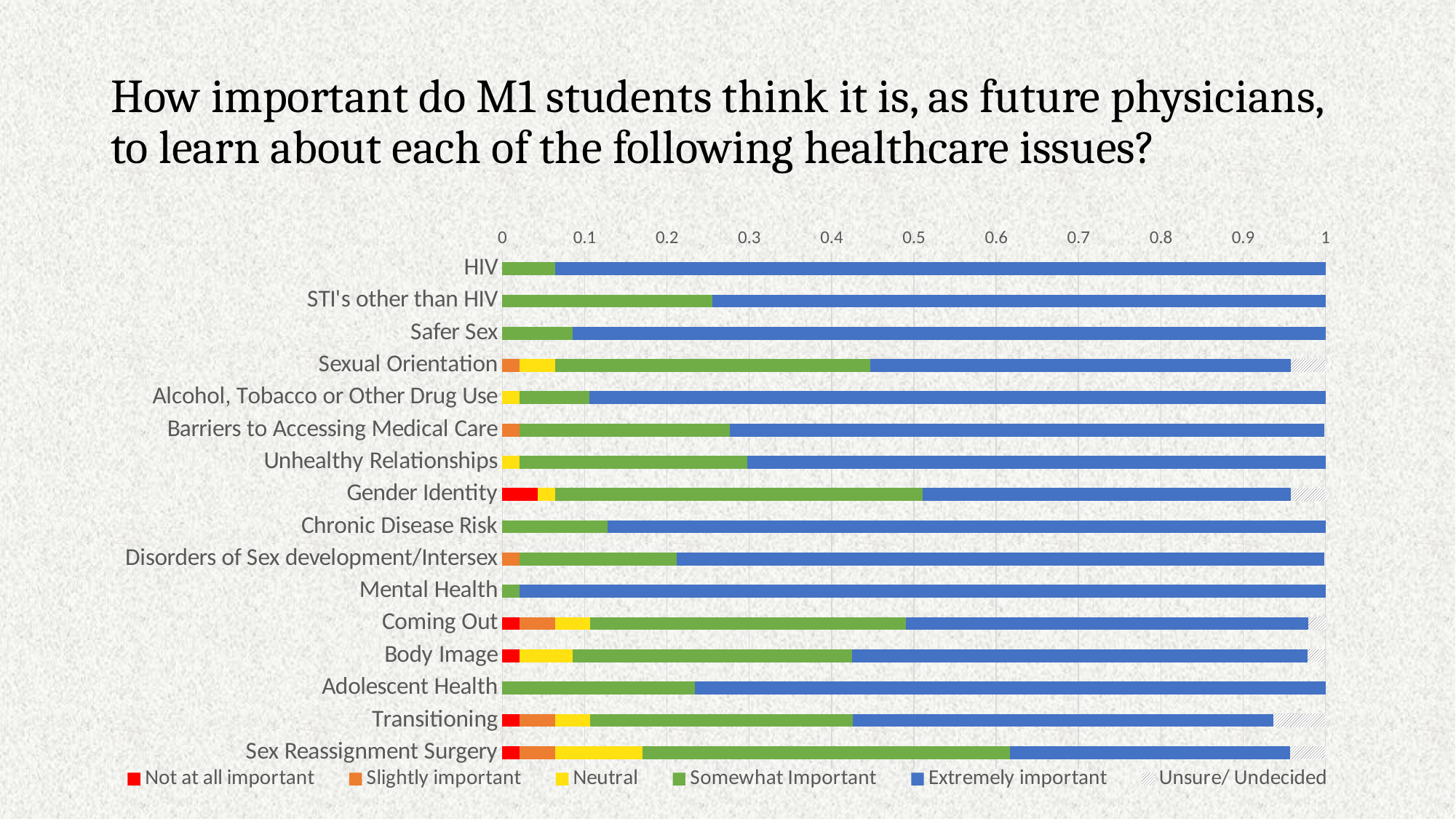
Is the 'Somewhat Important' share for HIV greater or less than 0.1? less Which has a larger 'Extremely important' share, HIV or STI's other than HIV? HIV What kind of chart is shown on the slide? Stacked bar chart What is the last entry in the chart's legend? Unsure/ Undecided Is the 'Extremely important' share for Mental Health greater or less than 0.9? greater Which healthcare issue has the smallest 'Extremely important' share? Sex Reassignment Surgery Which healthcare issue has the largest 'Extremely important' share? Mental Health Which has a larger 'Somewhat Important' share, Sexual Orientation or Chronic Disease Risk? Sexual Orientation How many healthcare issues show a 'Not at all important' (red) segment? 5 How many healthcare issues (categories) are listed on the chart? 16 How many series does the legend list? 6